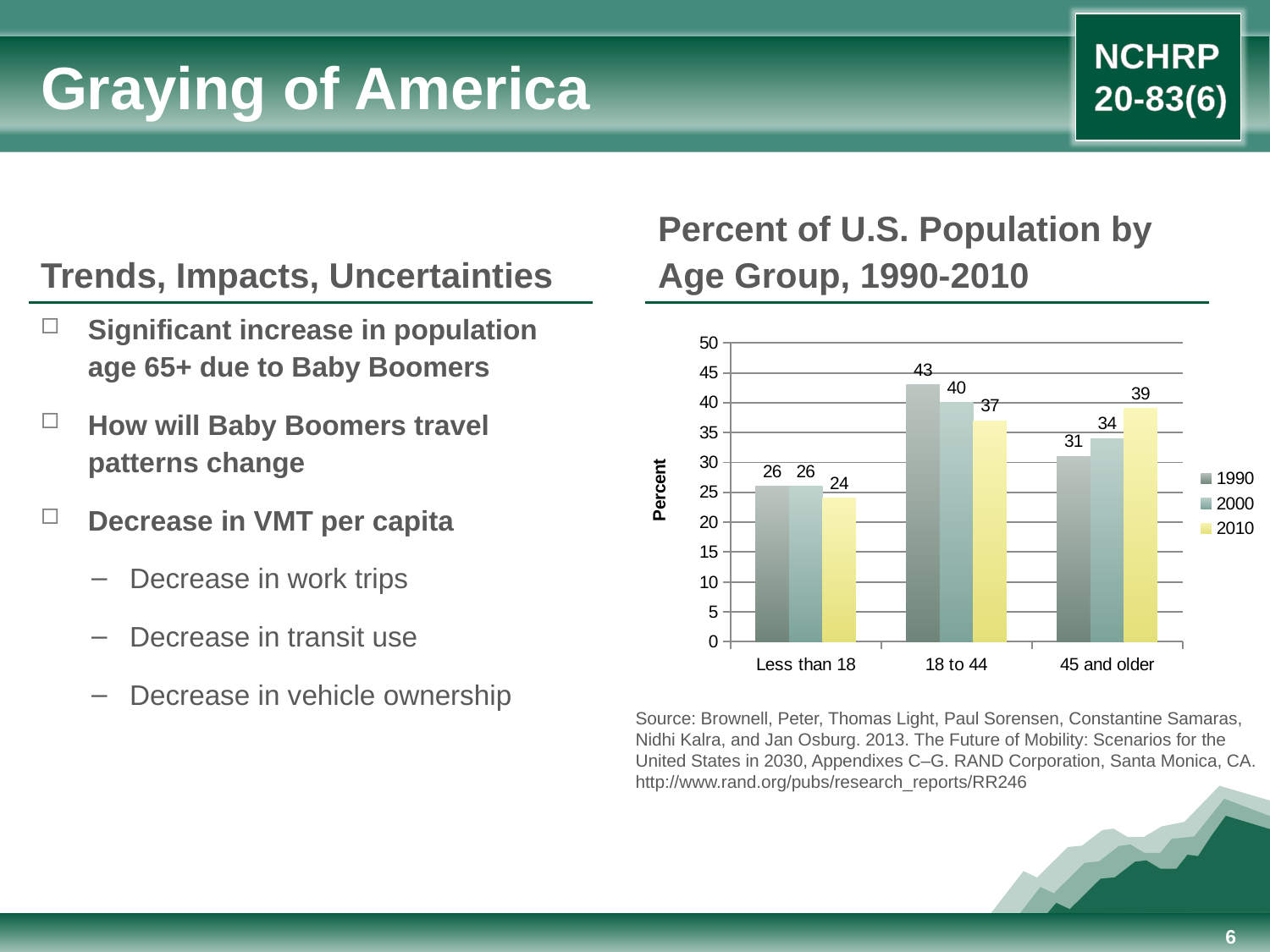
What is the difference between the 1990 and 2010 values for the 45 and older age group? 8 How many age groups are shown on the x axis? 3 Do the values for the 45 and older age group rise or fall from 1990 to 2010? Rise Which age group has the highest value in 2000? 18 to 44 What is the value for the 18 to 44 age group in 1990? 43 Which is larger for the 18 to 44 age group: the 1990 value or the 2010 value? 1990 What is the title of the chart? Percent of U.S. Population by Age Group, 1990-2010 What is the value for the 45 and older age group in 2010? 39 What is the value for the Less than 18 age group in 2010? 24 Which age group has the lowest value in 1990? Less than 18 What kind of chart is shown on the slide? Bar chart How many series does the legend list? 3